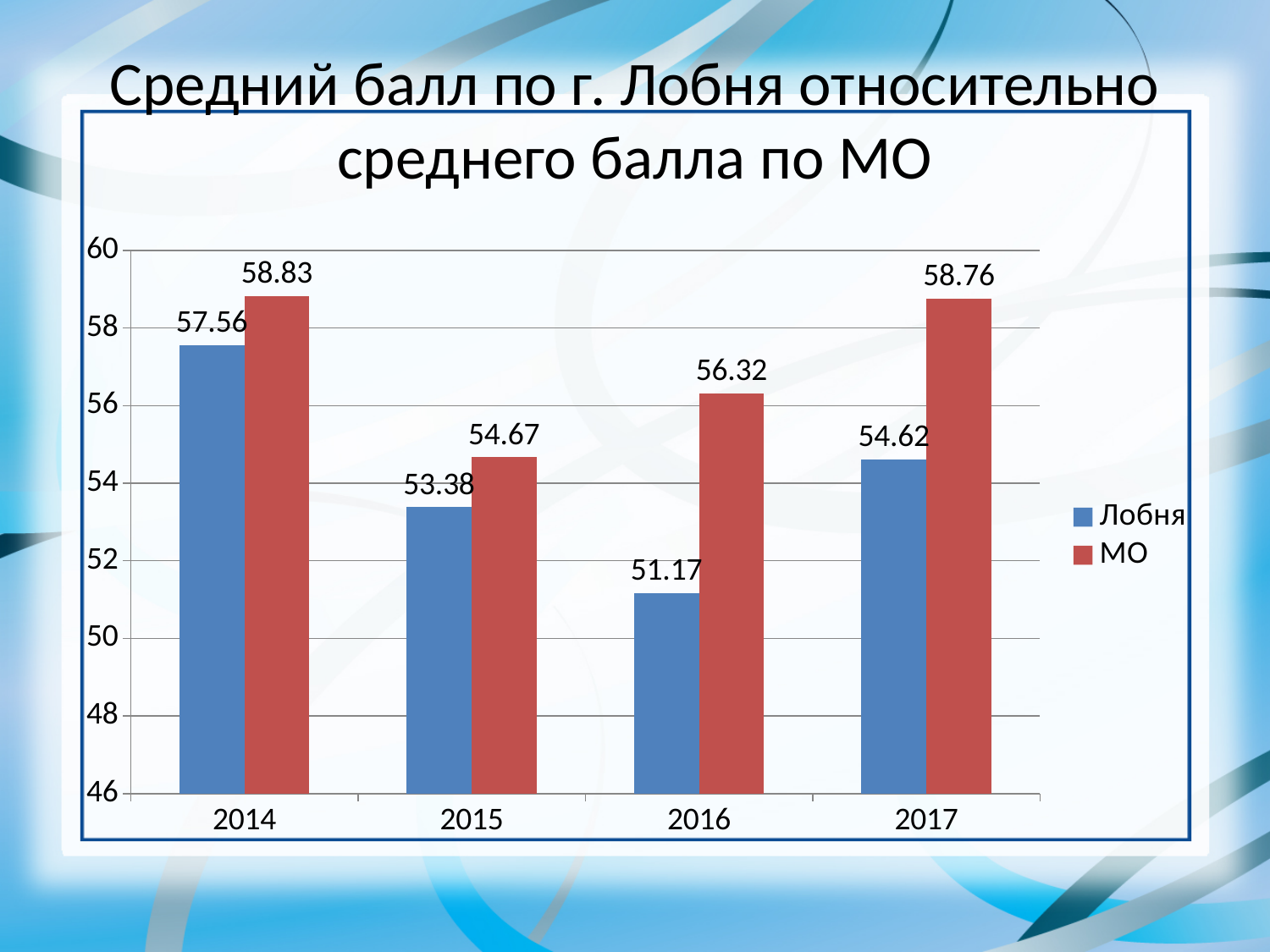
Which colour represents the МО series? red What is the value for МО in 2016? 56.32 Which is larger in 2015, the value for Лобня or the value for МО? МО What is the value for Лобня in 2014? 57.56 How many years are shown on the x axis? 4 What is the difference between the МО and Лобня values in 2016? 5.15 What is the value for Лобня in 2017? 54.62 What is the difference between the МО and Лобня values in 2014? 1.27 How many series does the legend list? 2 In which year is the value for Лобня the lowest? 2016 In which year is the value for МО the highest? 2014 What kind of chart is shown on the slide? bar chart